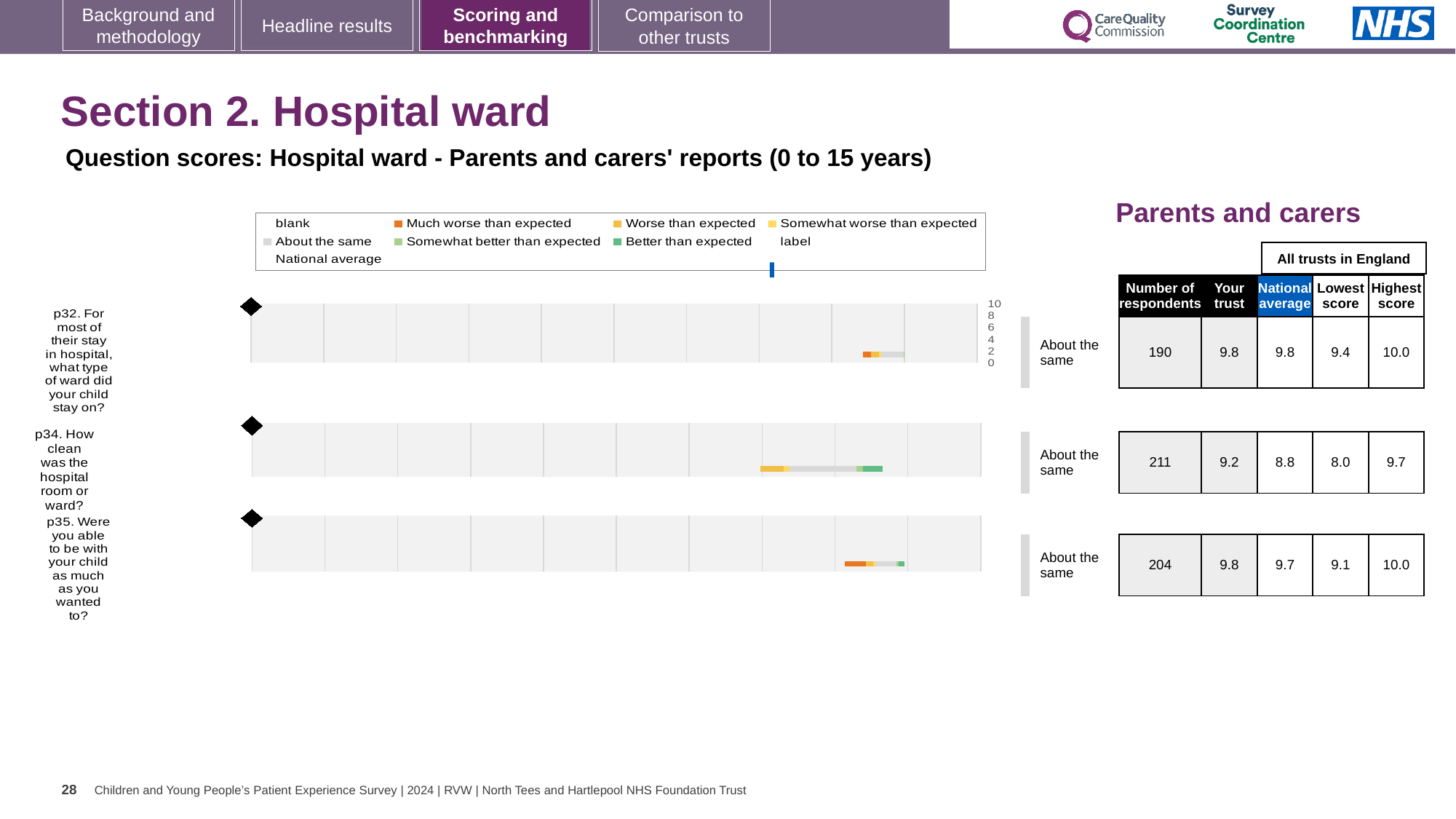
What is the lowest score among all trusts in England for p35? 9.1 Which question has the lowest 'Your trust' score? p34 What is the national average score for p35 (Were you able to be with your child as much as you wanted to?)? 9.7 What is the 'Your trust' score for p34 (How clean was the hospital room or ward?)? 9.2 Which legend entry is shown in dark orange? Much worse than expected What kind of chart is used to show the question scores for p32, p34 and p35? bar chart What is the difference between the highest and lowest scores among all trusts in England for p32? 0.6 What is the highest score among all trusts in England for p34? 9.7 How many respondents answered p32 (For most of their stay in hospital, what type of ward did your child stay on?)? 190 For p34, which is larger: the 'Your trust' score or the national average? Your trust What is the difference between the 'Your trust' score and the national average for p34? 0.4 How many questions are plotted on the slide? 3